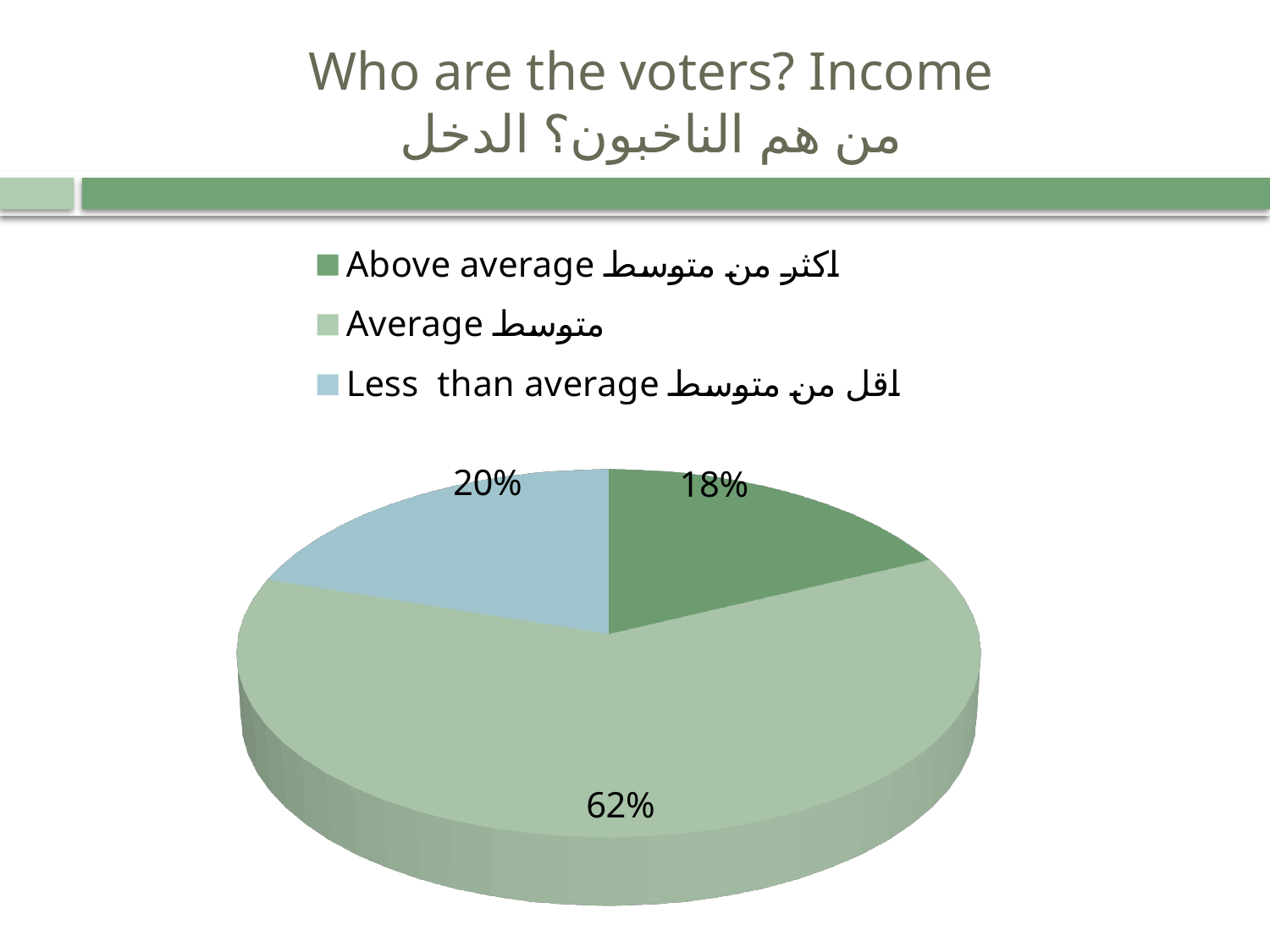
What is the difference in percentage points between the Average and Less than average slices? 42 What kind of chart is shown on the slide? Pie chart Which income category has the smallest share of voters? Above average Which is larger, the share for Above average or the share for Less than average? Less than average What is the difference in percentage points between the Less than average and Above average slices? 2 Which legend entry is shown in light blue? Less than average How many income categories are shown in the pie chart? 3 What is the combined share of the Above average and Less than average slices? 38% What share of voters have an average income? 62% What share of voters have an above average income? 18% What share of voters have a less than average income? 20% Which income category has the largest share of voters? Average